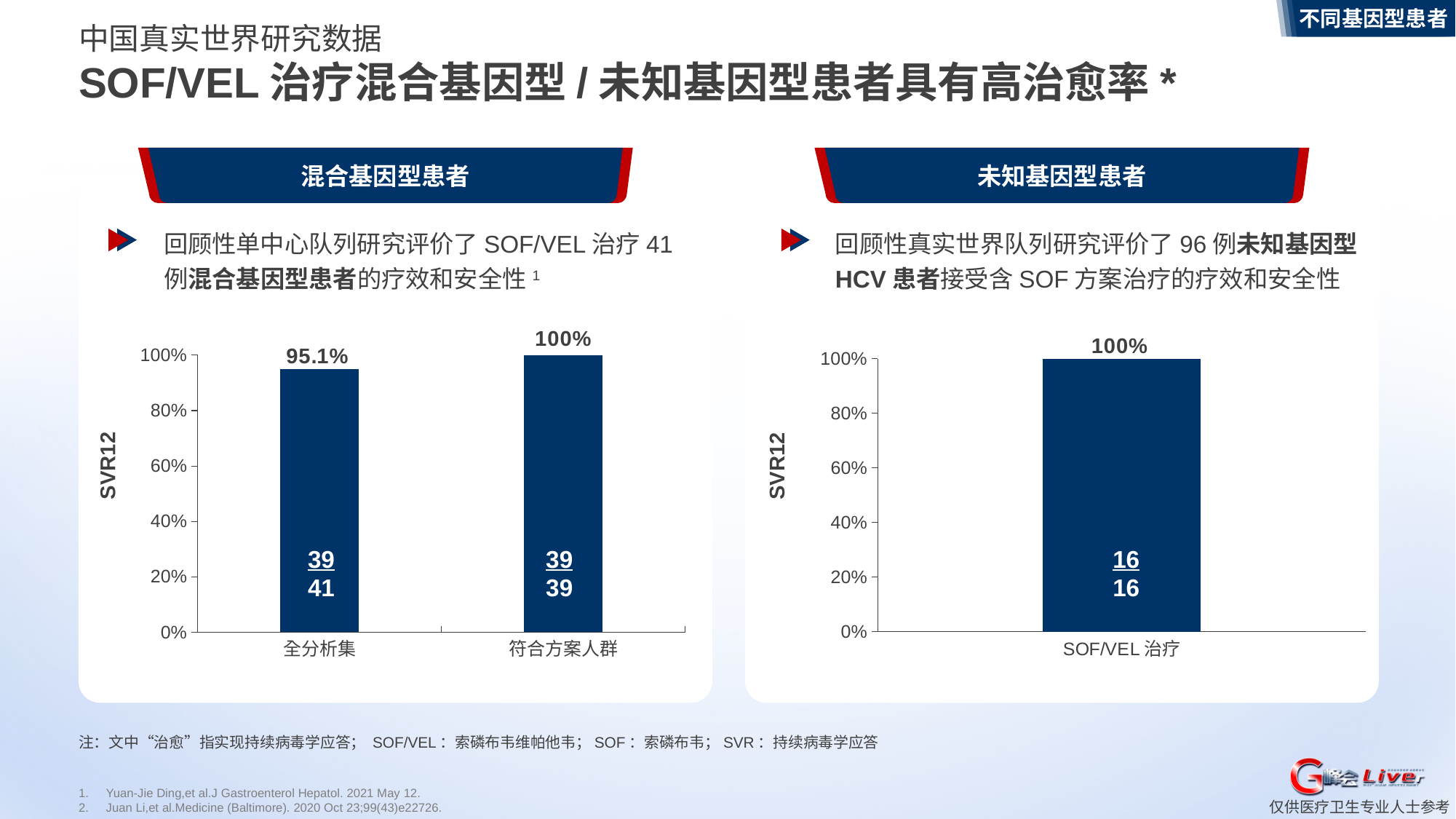
What is the y-axis label of the right chart (未知基因型患者)? SVR12 In the left chart (混合基因型患者), what is the SVR12 value for 全分析集? 95.1% How many bars are shown in the left chart (混合基因型患者)? 2 In the left chart (混合基因型患者), which category has the lowest SVR12? 全分析集 In the right chart (未知基因型患者), what is the SVR12 value for SOF/VEL 治疗? 100% How many bars are shown in the right chart (未知基因型患者)? 1 In the left chart (混合基因型患者), is the SVR12 for 全分析集 greater or less than 80%? greater In the left chart (混合基因型患者), which category has the highest SVR12? 符合方案人群 In the left chart (混合基因型患者), what fraction is printed inside the 全分析集 bar? 39/41 In the left chart (混合基因型患者), what is the difference in SVR12 between 符合方案人群 and 全分析集? 4.9% In the left chart (混合基因型患者), what is the SVR12 value for 符合方案人群? 100% What type of chart is used in the left panel (混合基因型患者)? Bar chart